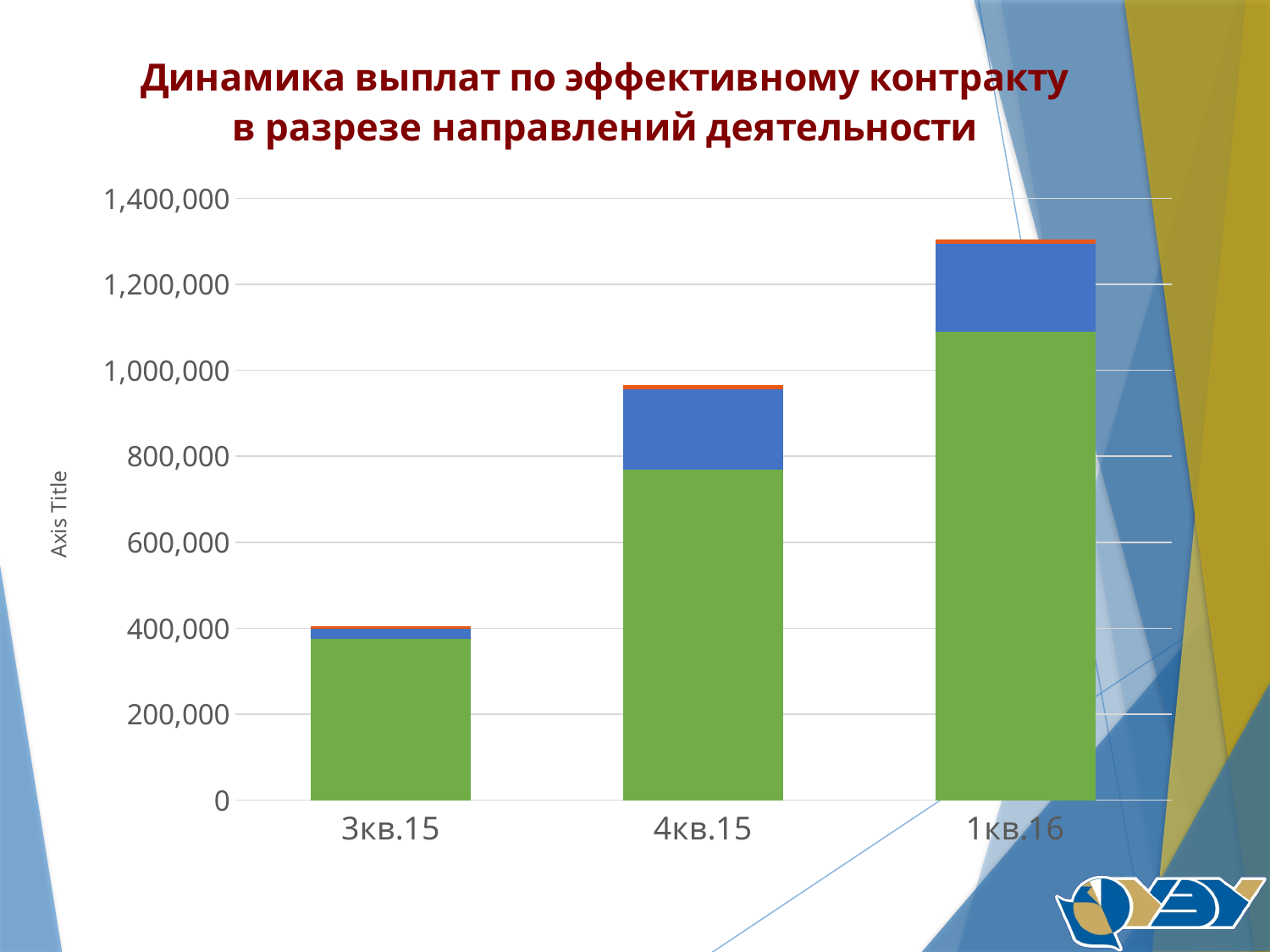
What kind of chart is shown on the slide? stacked bar chart Is the green segment for 1кв.16 greater or less than 1,000,000? greater Which category has the shortest stacked bar? 3кв.15 Is the total value for 4кв.15 greater or less than 800,000? greater Which category has the tallest stacked bar? 1кв.16 Is the total value for 1кв.16 greater or less than 1,200,000? greater What colour is the largest segment in each stacked bar? green How many categories are shown on the x axis of the chart? 3 Which is larger, the total bar for 4кв.15 or the total bar for 3кв.15? 4кв.15 Do the total bar heights rise or fall from 3кв.15 to 1кв.16? rise What is the title of the chart on the slide? Динамика выплат по эффективному контракту в разрезе направлений деятельности